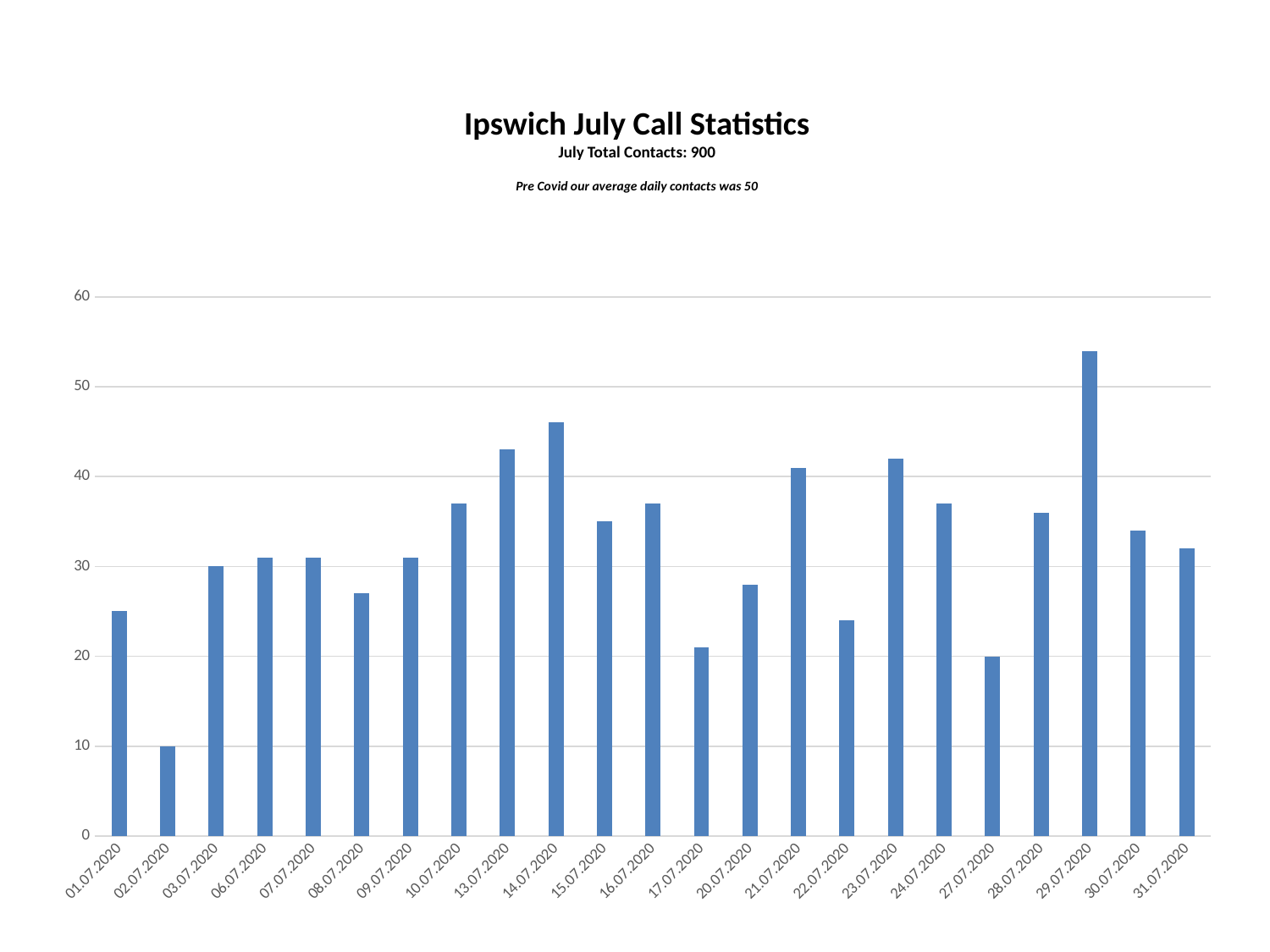
How many dates are plotted on the x axis? 23 Is the value for 14.07.2020 greater or less than 40? greater According to the chart subtitle, what was the July total contacts? 900 Which date has the lowest number of contacts? 02.07.2020 Which date has the highest number of contacts? 29.07.2020 Is the value for 17.07.2020 greater or less than 30? less What is the title of the chart? Ipswich July Call Statistics Is the value for 29.07.2020 greater or less than 50? greater Which has the larger value, 21.07.2020 or 20.07.2020? 21.07.2020 What is the value for 27.07.2020? 20 What is the value for 02.07.2020? 10 What type of chart is shown on the slide? bar chart